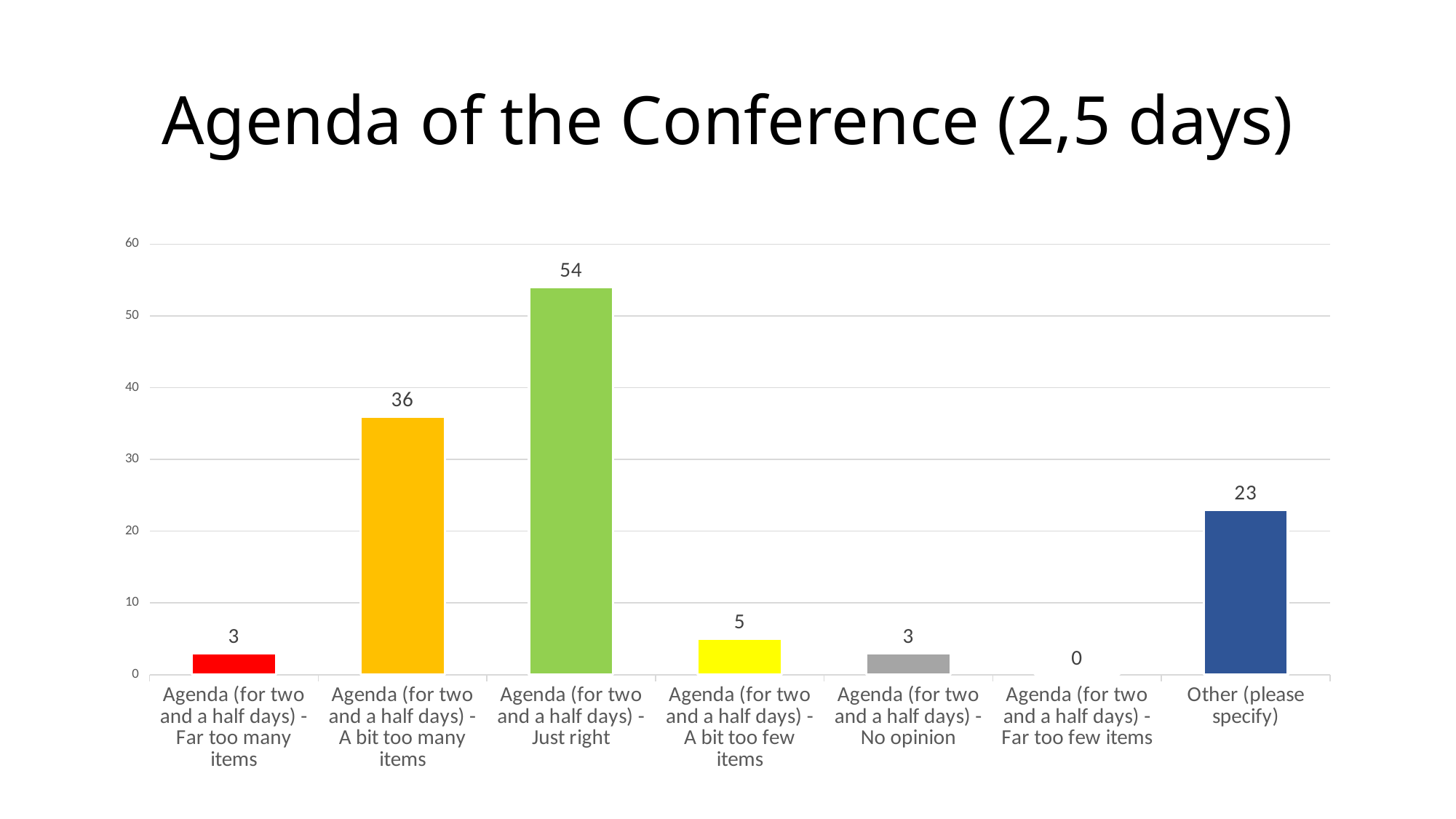
What is the value for "Agenda (for two and a half days) - A bit too many items"? 36 Is the value for "Agenda (for two and a half days) - A bit too many items" greater or less than 30? greater What is the value for "Other (please specify)"? 23 Which category has the highest value? Agenda (for two and a half days) - Just right How many categories are shown on the x axis? 7 What is the difference between the values for "Just right" and "A bit too many items"? 18 What is the value for "Agenda (for two and a half days) - Just right"? 54 What is the value for "Agenda (for two and a half days) - Far too few items"? 0 Which category has the lowest value? Agenda (for two and a half days) - Far too few items What kind of chart is shown on the slide? Bar chart Which is larger: the value for "Other (please specify)" or the value for "A bit too few items"? Other (please specify) What is the title of the slide? Agenda of the Conference (2,5 days)